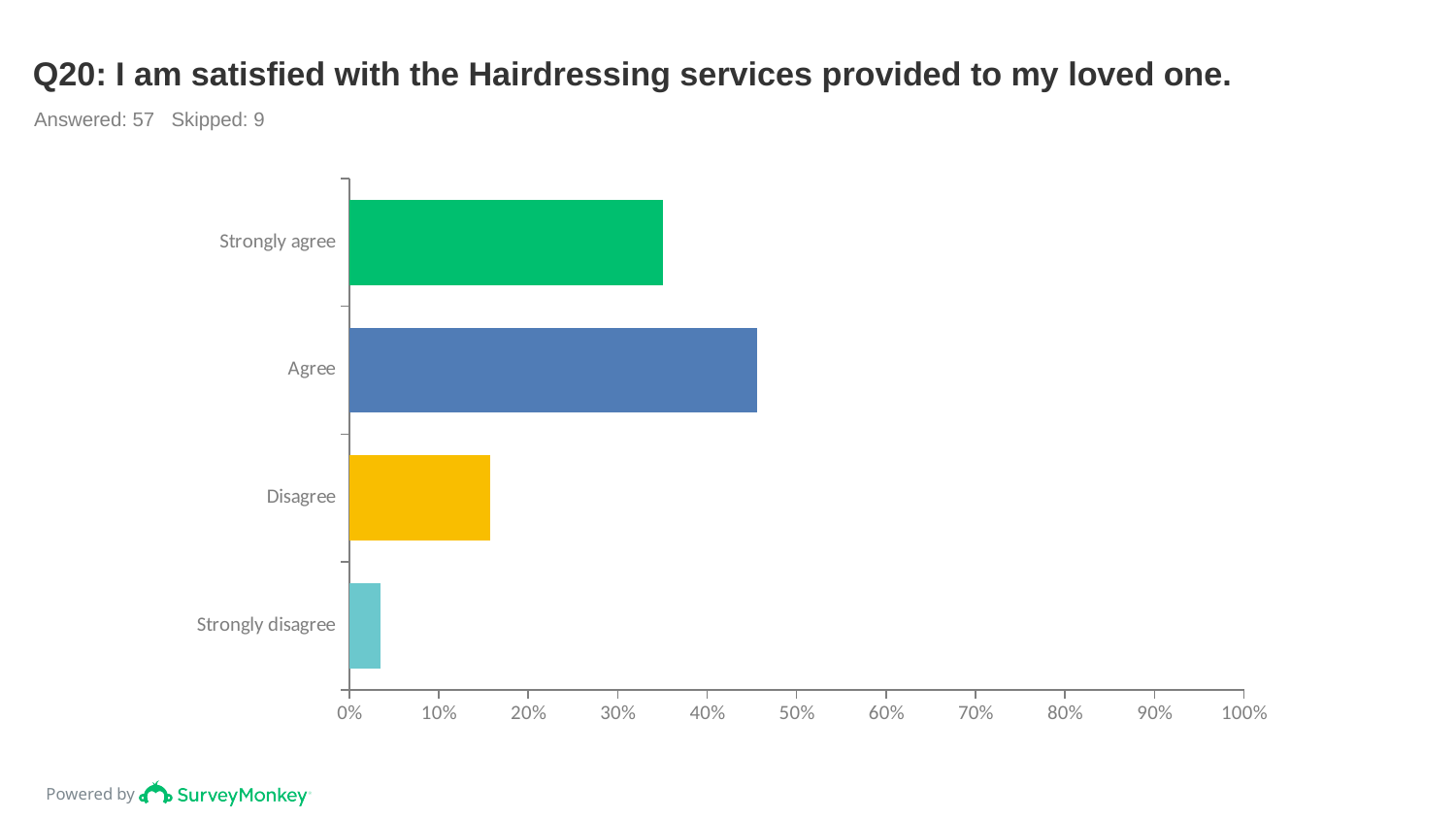
Is the value for Agree greater or less than 40%? greater Is the value for Strongly agree greater or less than 40%? less Which is larger, the value for Agree or the value for Strongly agree? Agree Which response category has the lowest value? Strongly disagree Which is larger, the value for Strongly agree or the value for Disagree? Strongly agree Which response category has the highest value? Agree What is the maximum value shown on the horizontal axis? 100% Is the value for Disagree greater or less than 10%? greater How many respondents answered this question, according to the slide? 57 How many response categories are plotted in the chart? 4 What kind of chart is shown on the slide? bar chart